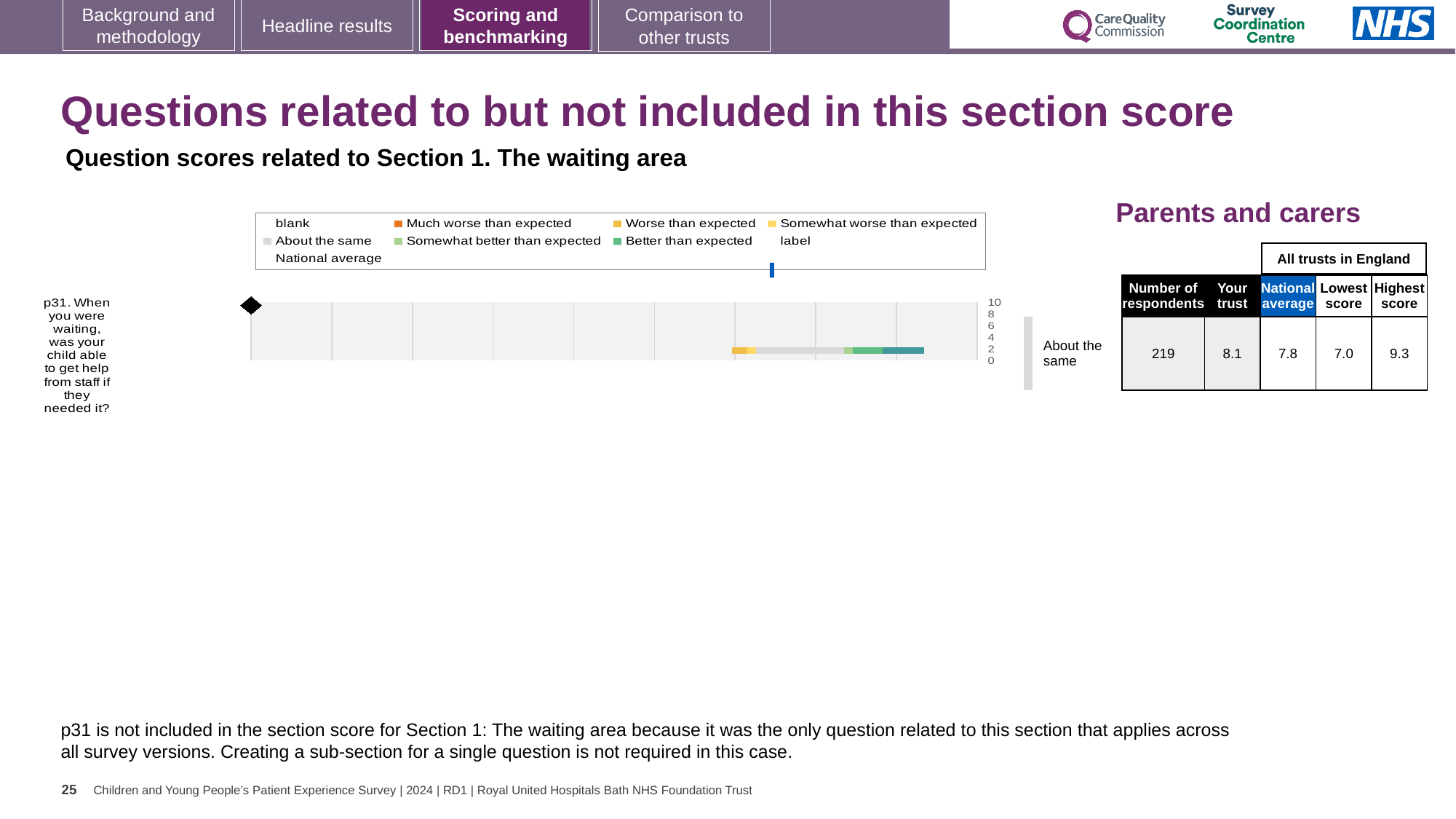
In the Parents and carers table, what is the difference between the 'Your trust' score and the national average for p31? 0.3 In the Parents and carers table, what is the difference between the highest and lowest scores for p31? 2.3 In the Parents and carers table, what is the 'Your trust' score for question p31? 8.1 In the Parents and carers table, is the 'Your trust' score for p31 higher or lower than the national average? higher What benchmarking category label is shown to the right of the bar for p31? About the same How many survey questions are plotted in the benchmarking chart? 1 In the Parents and carers table, what is the national average score for question p31? 7.8 In the Parents and carers table, how many respondents answered question p31? 219 What kind of chart is used to show the benchmarking result for question p31? bar chart In the Parents and carers table, what is the highest score among all trusts in England for question p31? 9.3 In the Parents and carers table, what is the lowest score among all trusts in England for question p31? 7.0 Which legend entry in the benchmarking chart is shown in orange? Much worse than expected